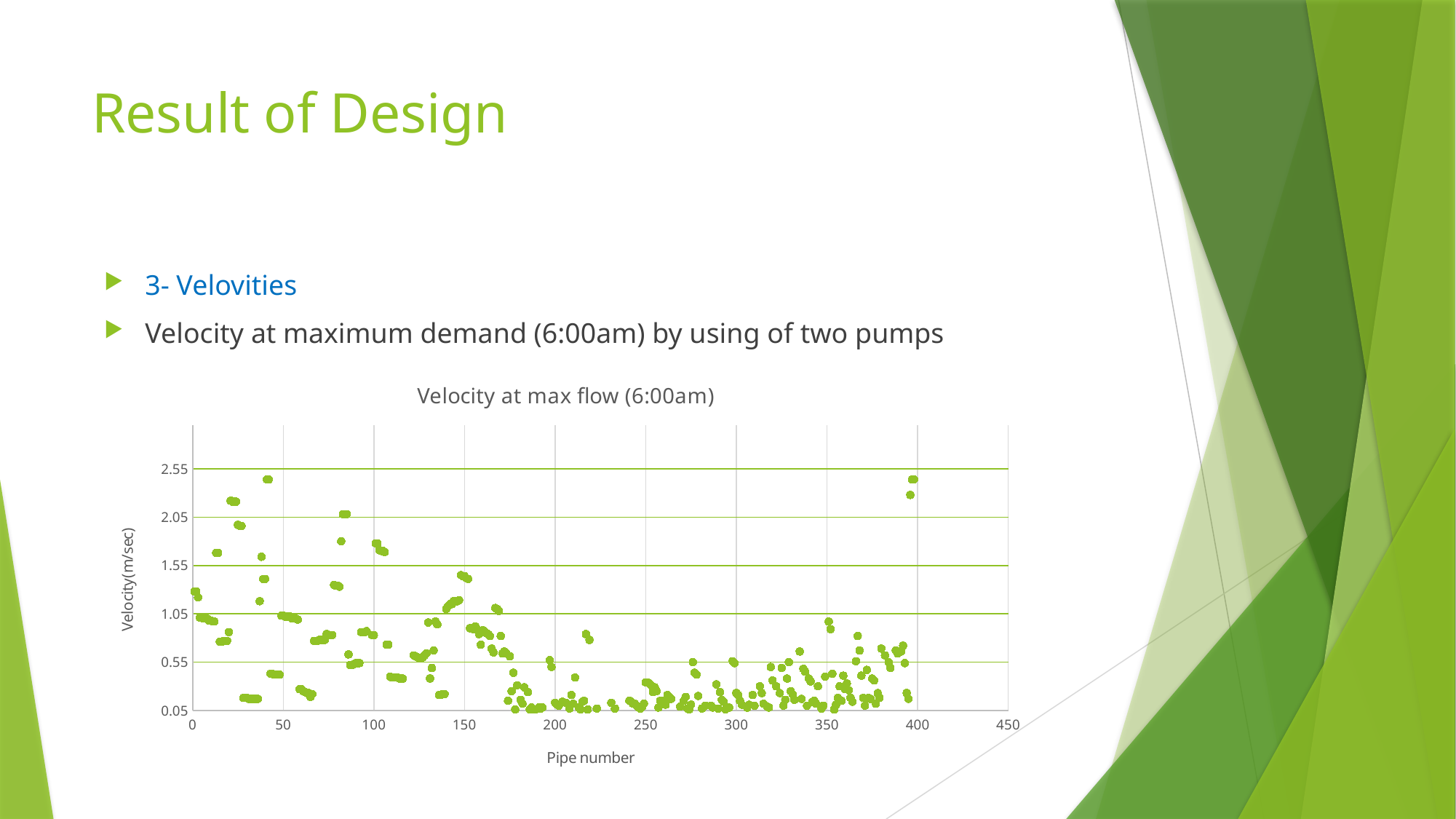
Is the velocity of the highest point near pipe number 40 greater or less than 2.05? greater What kind of chart is shown on the slide? scatter chart What is the label of the vertical axis of the chart? Velocity(m/sec) Do the plotted velocities generally rise or fall as the pipe number increases? fall What is the title of the chart? Velocity at max flow (6:00am) Is the highest plotted velocity greater or less than 2.05? greater What is the largest tick value shown on the horizontal axis? 450 Are the velocities plotted for pipe numbers between 250 and 300 greater or less than 1.05? less